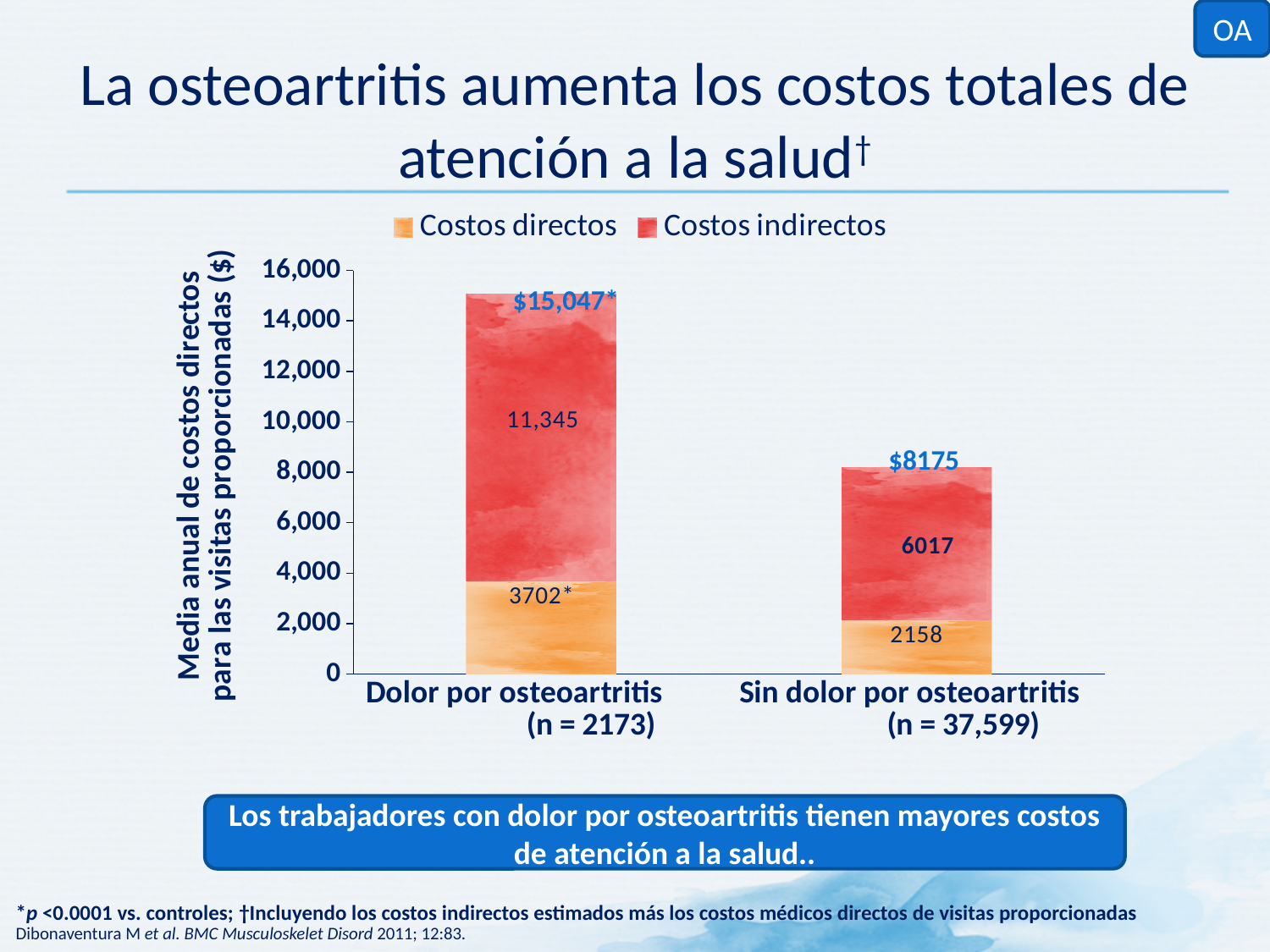
What is the difference in Costos indirectos between Dolor por osteoartritis and Sin dolor por osteoartritis? 5,328 What is the value of Costos directos for Dolor por osteoartritis? 3702 What type of chart is shown on the slide? Stacked bar chart What is the total labelled on the stacked bar for Dolor por osteoartritis? $15,047* Which series is shown in red in the legend? Costos indirectos Which category has the higher total cost? Dolor por osteoartritis What is the total labelled on the stacked bar for Sin dolor por osteoartritis? $8175 How many series does the legend list? 2 What is the value of Costos indirectos for Sin dolor por osteoartritis? 6017 What is the value of Costos indirectos for Dolor por osteoartritis? 11,345 How many categories are shown on the x axis? 2 What is the value of Costos directos for Sin dolor por osteoartritis? 2158